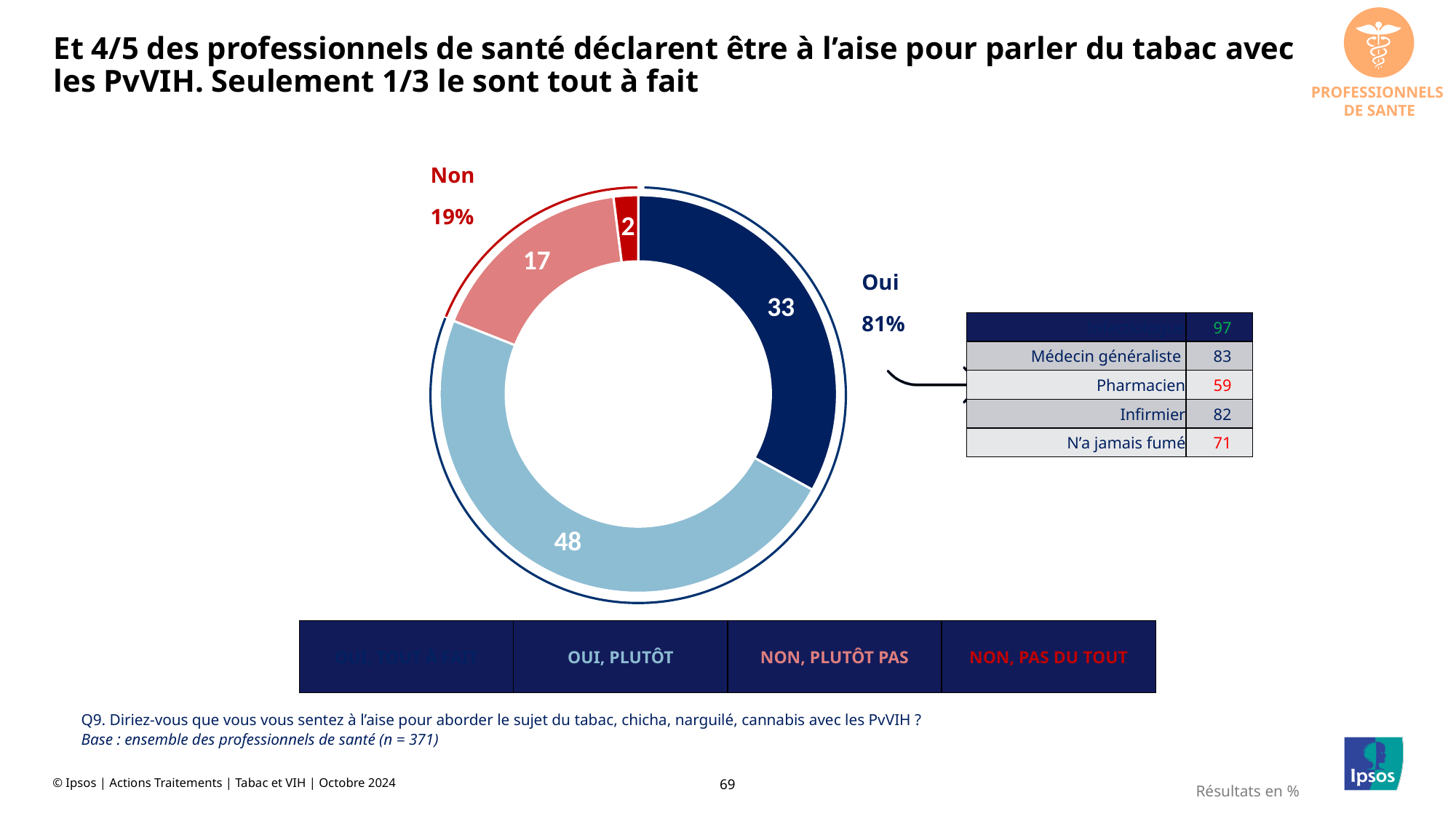
What is the value of the 'Oui, plutôt' segment in the donut chart? 48 Which segment of the donut chart is the smallest? Non, pas du tout What is the value of the 'Oui, tout à fait' segment in the donut chart? 33 What is the value of the 'Non, plutôt pas' segment in the donut chart? 17 What is the combined share labelled 'Non' on the donut chart? 19% What is the value of the 'Non, pas du tout' segment in the donut chart? 2 What is the combined share labelled 'Oui' on the donut chart? 81% Which segment of the donut chart is the largest? Oui, plutôt How many entries does the legend below the donut chart list? 4 What kind of chart is shown on the slide? Donut (pie) chart What is the difference between the 'Oui, plutôt' and 'Oui, tout à fait' segments? 15 How many segments does the donut chart have? 4